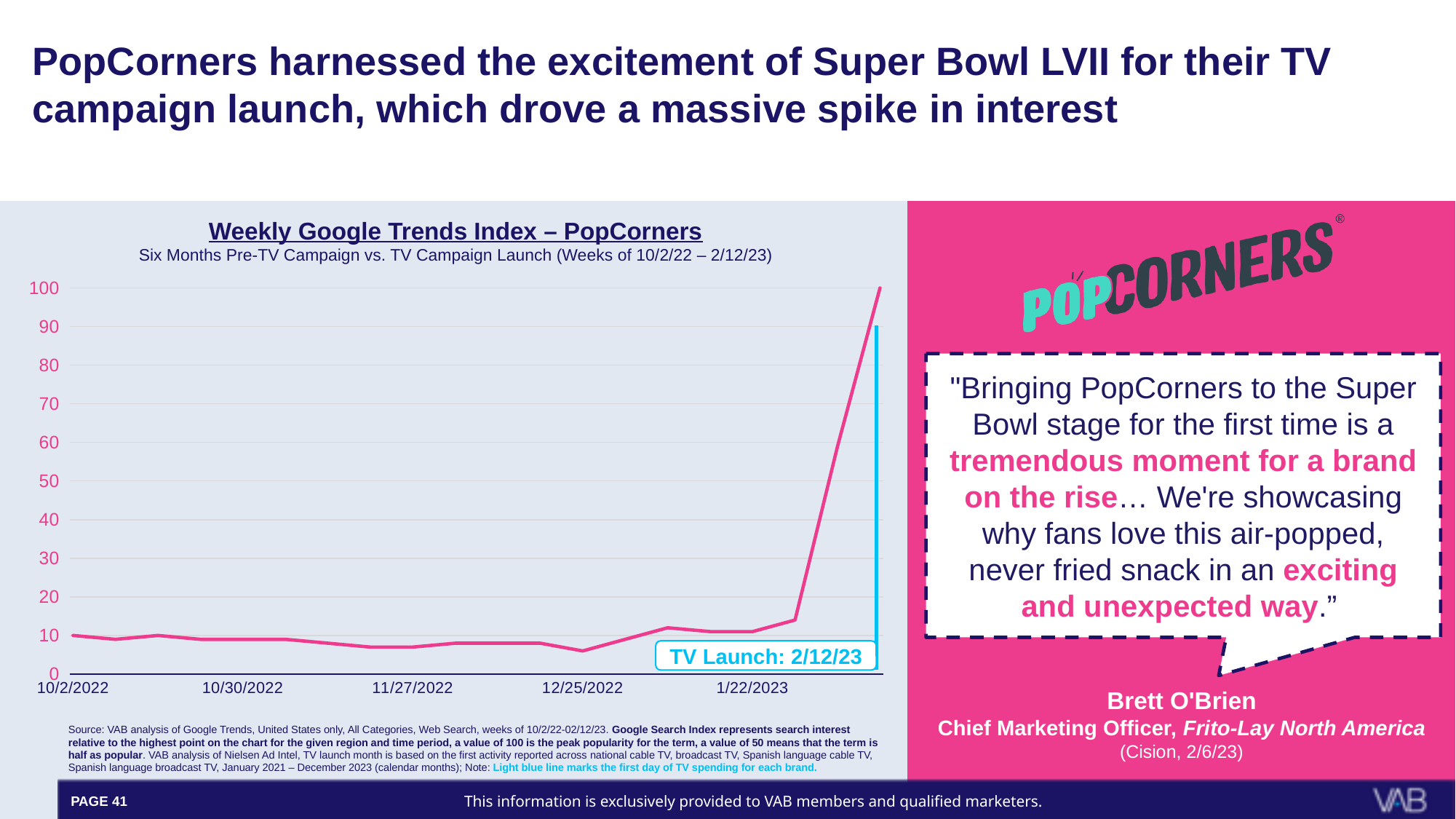
What is the Google Trends Index value at the peak of the line, the week of the TV launch? 100 Is the value for 10/30/2022 greater or less than 50? less Is the value for 10/2/2022 greater or less than 20? less Is the value for 12/25/2022 greater or less than 10? less Does the line rise or fall between 1/22/2023 and the end of the chart? rise Which is larger, the value for 10/2/2022 or the value for 12/25/2022? 10/2/2022 What date does the light blue vertical line on the chart mark as the TV launch? 2/12/23 How many date labels are shown on the x axis of the chart? 5 Which week has the highest Google Trends Index value on the chart? 2/12/23 What kind of chart is shown on the slide? line chart What is the title of the chart? Weekly Google Trends Index – PopCorners